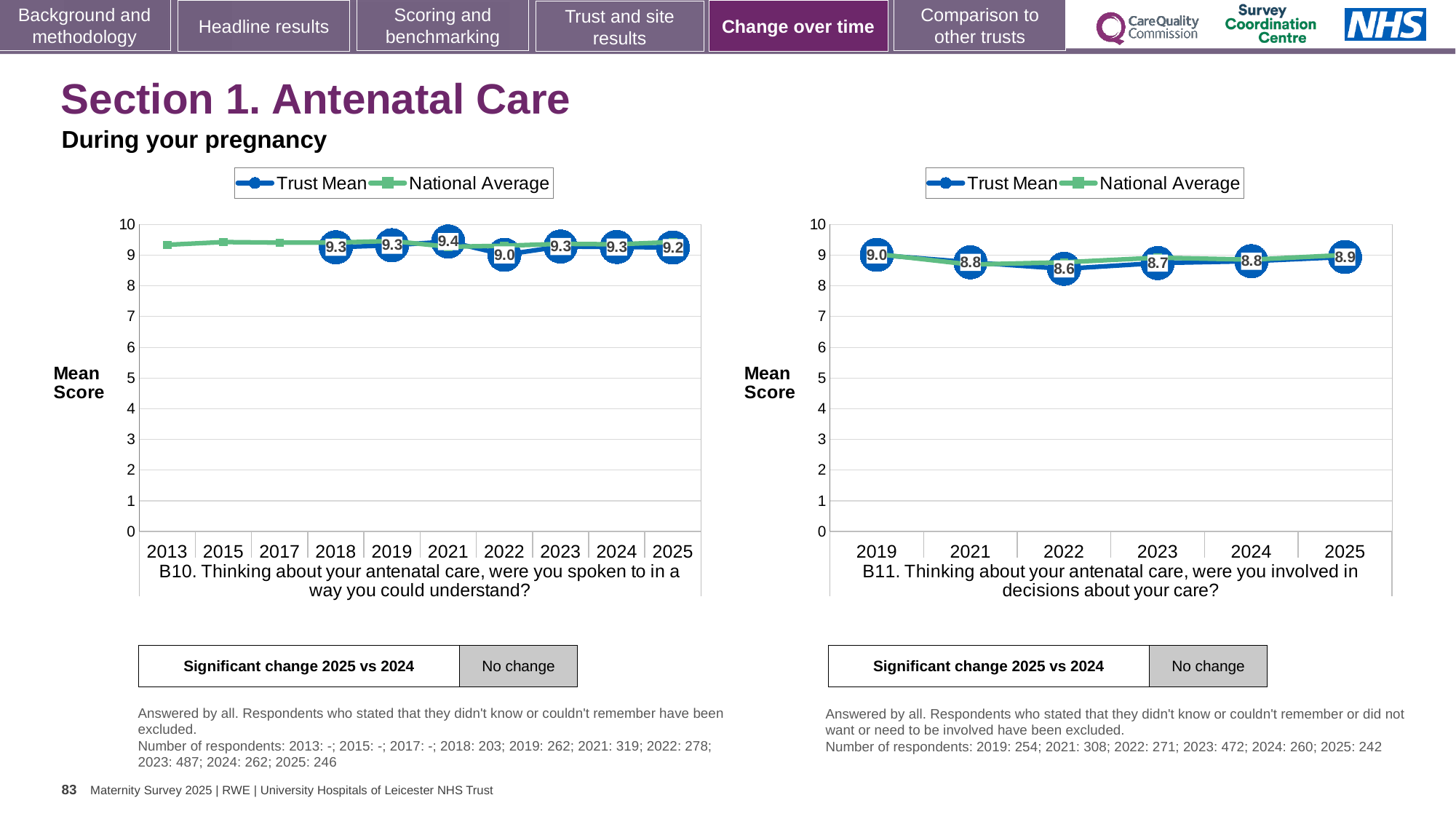
In the B10 chart on the left, which year has the highest labelled Trust Mean? 2021 How many years are shown on the x axis of the B11 chart on the right? 6 In the B10 chart on the left, what is the Trust Mean for 2025? 9.2 In the B11 chart on the right, what is the difference between the Trust Mean for 2019 and for 2022? 0.4 In the B11 chart on the right, is the Trust Mean for 2025 greater or less than 8? greater How many series does the legend of the B10 chart on the left list? 2 What type of chart is the B10 chart on the left? Line chart In the B10 chart on the left, what is the Trust Mean for 2022? 9.0 In the B11 chart on the right, what is the Trust Mean for 2022? 8.6 In the B10 chart on the left, which is larger, the Trust Mean for 2021 or for 2022? 2021 In the B11 chart on the right, what is the Trust Mean for 2019? 9.0 In the B11 chart on the right, which year has the lowest Trust Mean? 2022